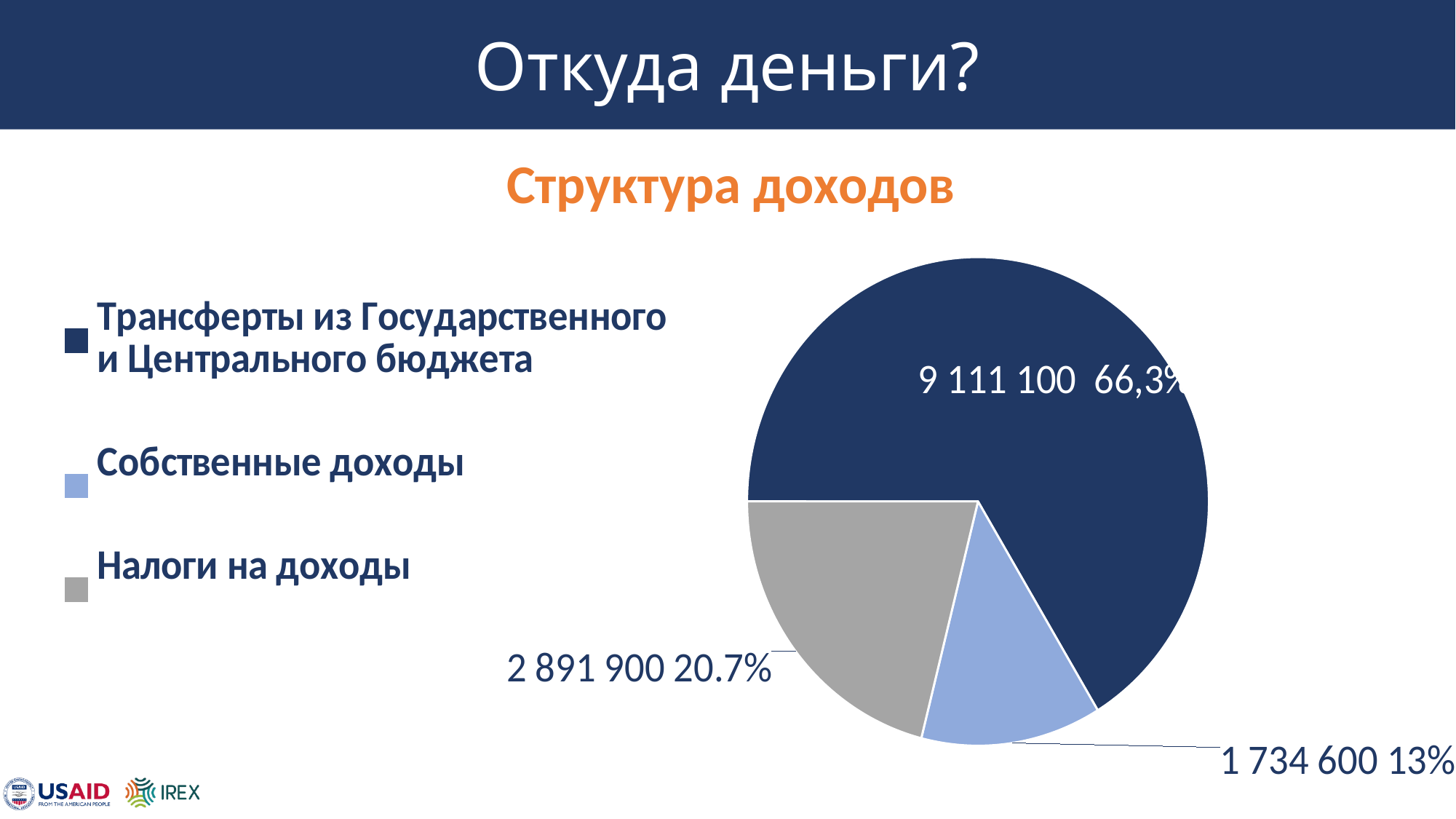
What is the value for Собственные доходы? 1 734 600 What is the value for Трансферты из Государственного и Центрального бюджета? 9 111 100 How many slices does the pie chart have? 3 Which category has the largest slice? Трансферты из Государственного и Центрального бюджета What is the title of the chart? Структура доходов What is the value for Налоги на доходы? 2 891 900 What is the difference between the values for Налоги на доходы and Собственные доходы? 1 157 300 What share of the pie is Налоги на доходы? 20.7% What share of the pie is Трансферты из Государственного и Центрального бюджета? 66,3% What kind of chart is shown on the slide? pie chart Which category has the smallest slice? Собственные доходы How many entries does the legend list? 3